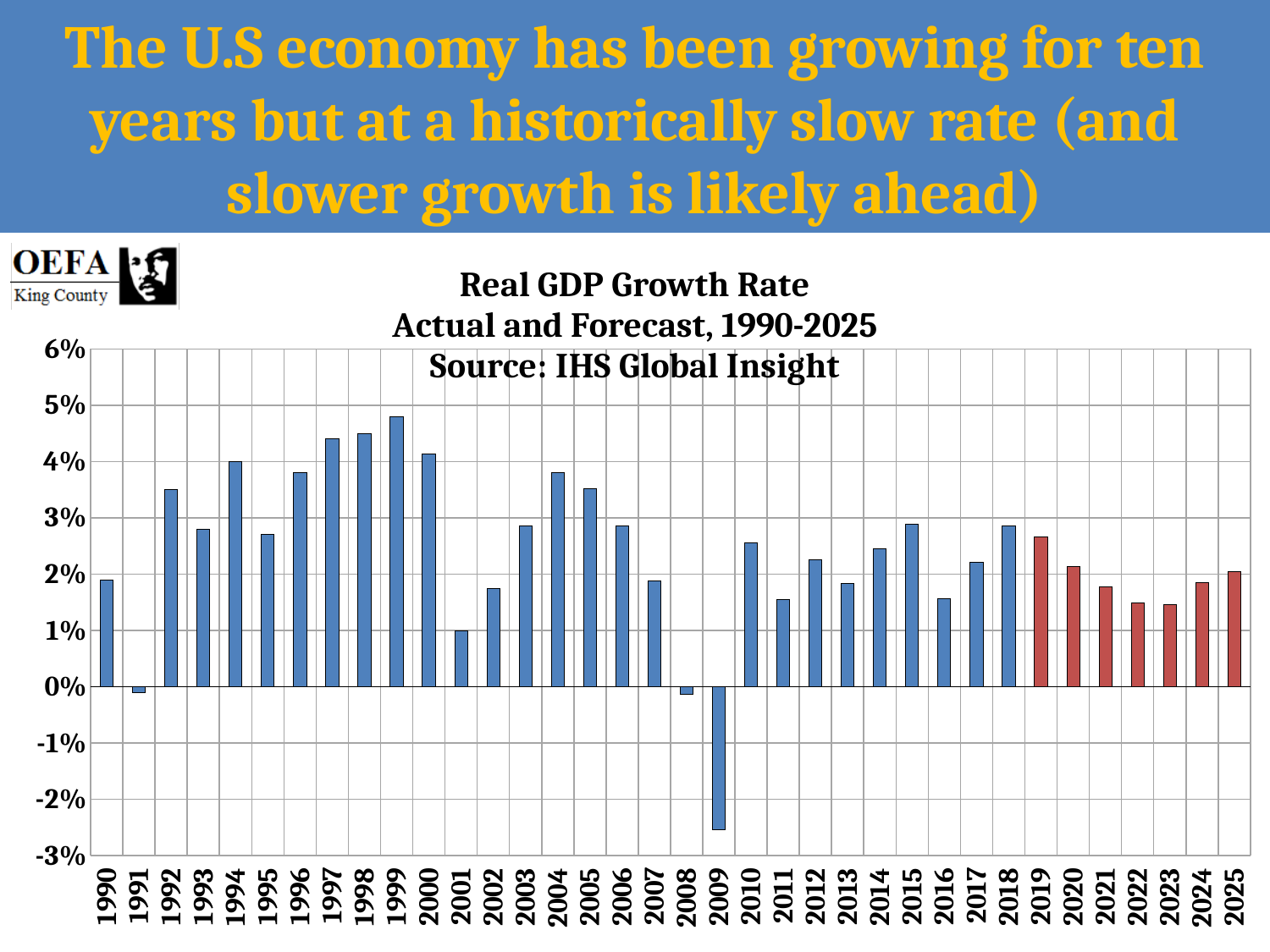
Which year has the larger growth rate, 2015 or 2016? 2015 What source is cited in the chart title? IHS Global Insight Is the value for 1991 greater or less than 0%? less How many years are plotted on the x axis? 36 Is the value for 2019 greater or less than 2%? greater Is the value for 2009 greater or less than -2%? less Which year has the highest real GDP growth rate? 1999 What kind of chart is shown on the slide? bar chart Which year has the lowest real GDP growth rate? 2009 Which year has the larger growth rate, 1998 or 2000? 1998